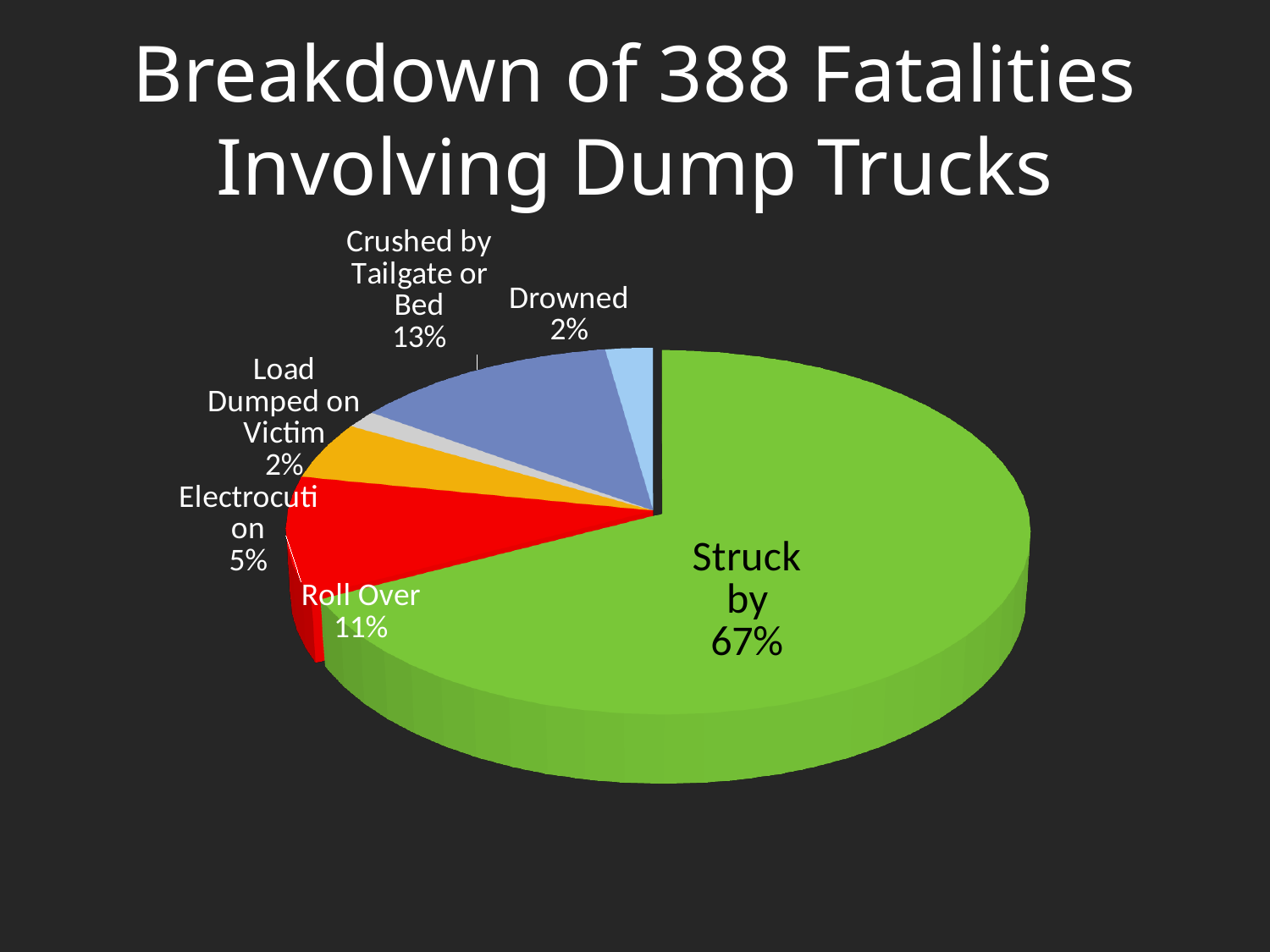
What share of fatalities is attributed to Struck by? 67% What is the title of the chart? Breakdown of 388 Fatalities Involving Dump Trucks What colour is the Struck by slice? Green What percentage of fatalities is attributed to Roll Over? 11% What type of chart is shown on the slide? Pie chart What percentage of fatalities is attributed to Drowned? 2% Which is larger, the share for Crushed by Tailgate or Bed or the share for Roll Over? Crushed by Tailgate or Bed What is the difference in percentage points between Struck by and Roll Over? 56 Which category accounts for the largest share of fatalities? Struck by How many categories are shown in the pie chart? 6 What percentage of fatalities is attributed to Crushed by Tailgate or Bed? 13% What percentage of fatalities is attributed to Electrocution? 5%